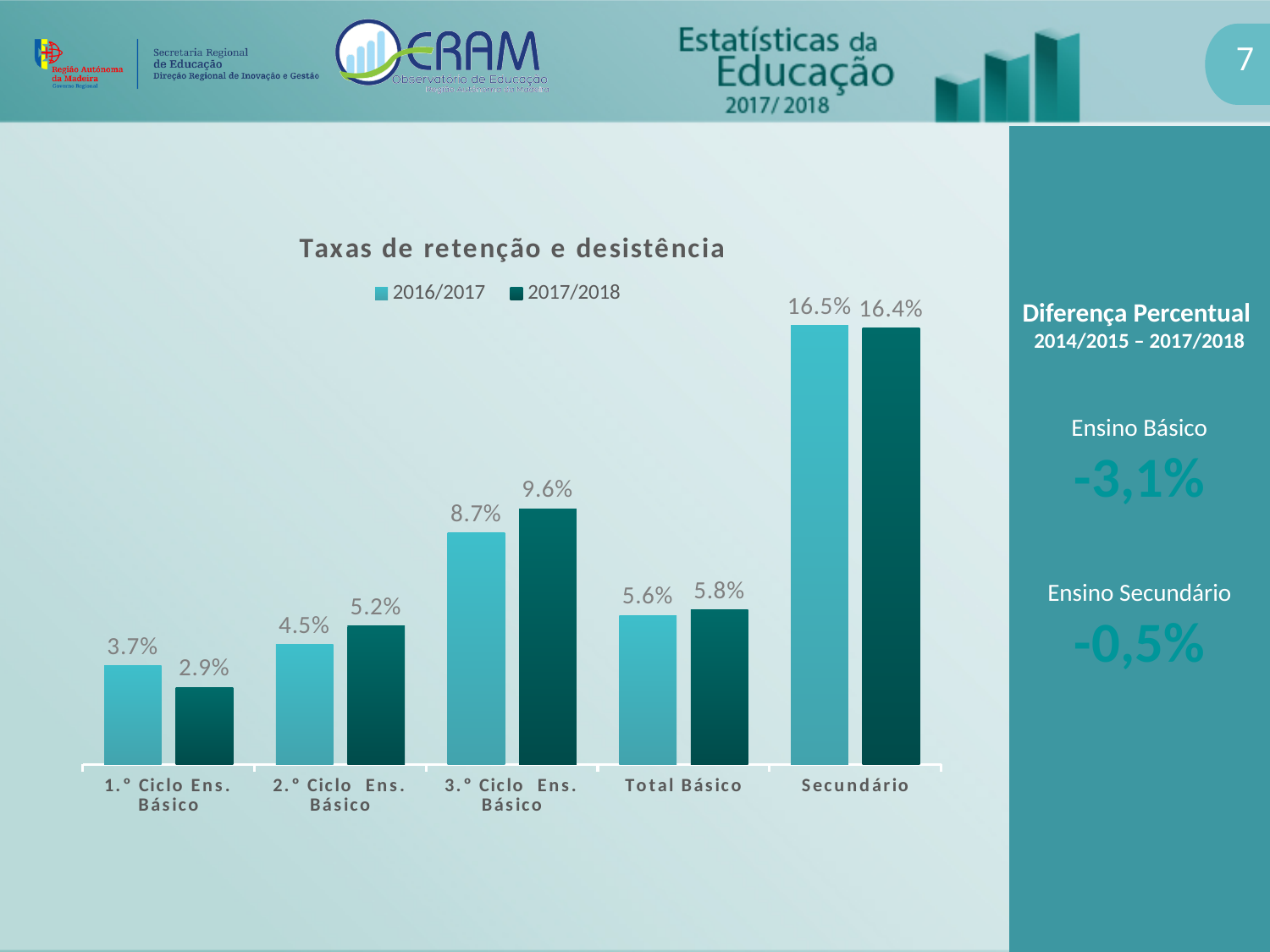
Which category has the lowest value in the 2016/2017 series? 1.º Ciclo Ens. Básico How many series does the legend list? 2 What is the difference between the 2017/2018 and 2016/2017 values for 3.º Ciclo Ens. Básico? 0.9% Which category has the highest value in the 2017/2018 series? Secundário What is the value for 1.º Ciclo Ens. Básico in 2016/2017? 3.7% What is the title of the chart? Taxas de retenção e desistência What is the value for 3.º Ciclo Ens. Básico in 2017/2018? 9.6% What is the value for Secundário in 2017/2018? 16.4% How many categories are shown on the x axis? 5 For 1.º Ciclo Ens. Básico, which series has the larger value, 2016/2017 or 2017/2018? 2016/2017 What kind of chart is shown on the slide? Bar chart What is the value for Total Básico in 2016/2017? 5.6%